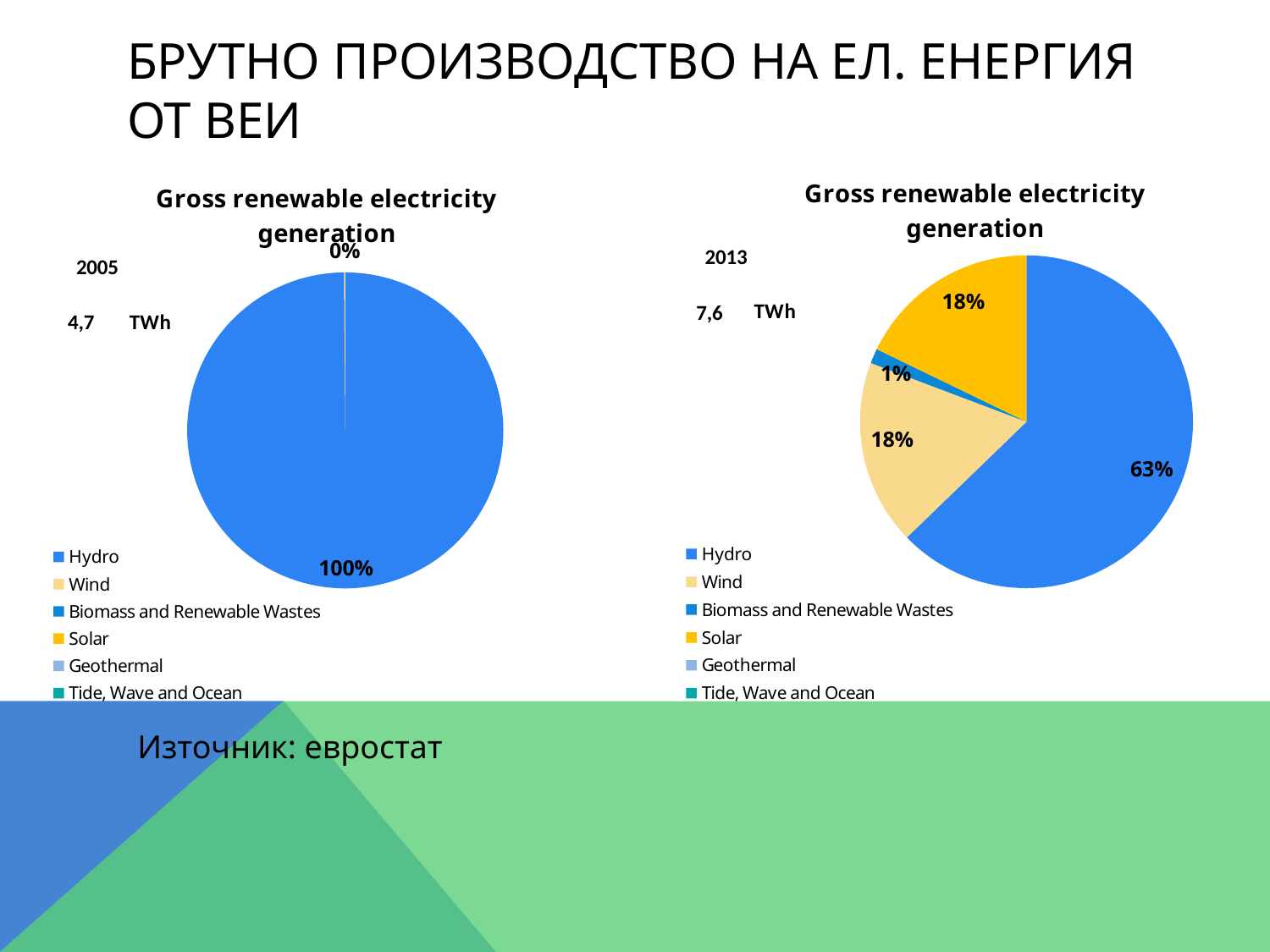
What is the title of the right chart (2013)? Gross renewable electricity generation In the right pie chart (2013), what is the difference between the Solar share and the Biomass and Renewable Wastes share? 17% In the right pie chart (2013), what share does Wind have? 18% What kind of chart is the left chart (2005)? Pie chart In the right pie chart (2013), what share does Biomass and Renewable Wastes have? 1% How many entries does the legend of the right chart (2013) list? 6 In the right pie chart (2013), what share does Solar have? 18% In the right pie chart (2013), which category has the largest share? Hydro In the right pie chart (2013), what is the difference between the Hydro share and the Wind share? 45% In the right pie chart (2013), what share does Hydro have? 63% In the right pie chart (2013), which of Hydro or Wind has the larger share? Hydro In the left pie chart (2005), what share does Hydro have? 100%